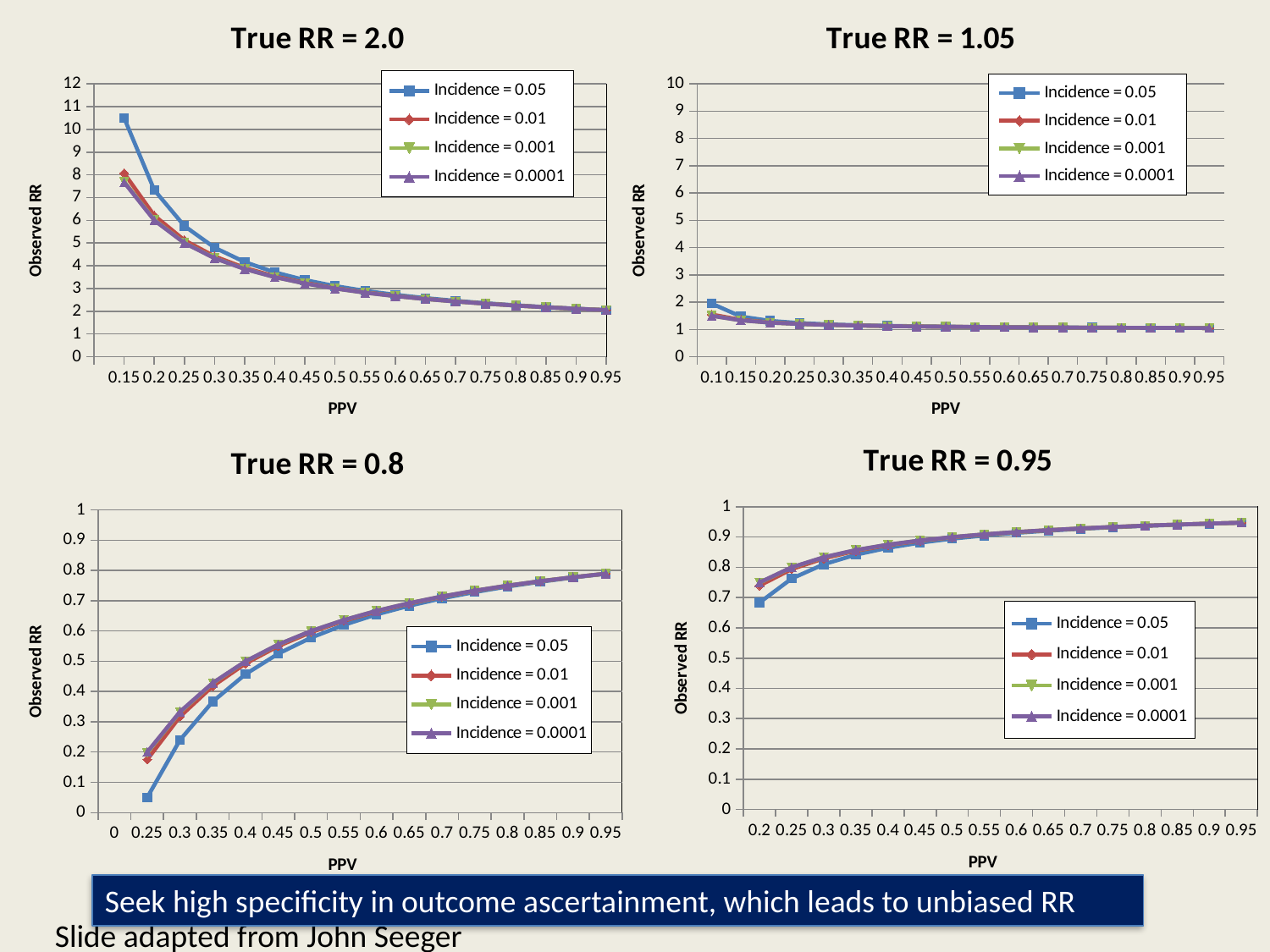
What is the y-axis label of the chart titled "True RR = 0.95"? Observed RR In the chart titled "True RR = 2.0", is the value for Incidence = 0.05 at PPV 0.15 greater or less than 10? greater In the chart titled "True RR = 0.8", at PPV 0.25, which is larger: the value for Incidence = 0.05 or the value for Incidence = 0.0001? Incidence = 0.0001 In the chart titled "True RR = 0.8", is the value for Incidence = 0.05 at PPV 0.25 greater or less than 0.1? less In the chart titled "True RR = 0.8", do the values rise or fall as PPV increases? rise How many PPV points are plotted along the x axis of the chart titled "True RR = 2.0"? 17 In the chart titled "True RR = 0.95", is the value for Incidence = 0.05 at PPV 0.2 greater or less than 0.7? less How many series does the legend list in the chart titled "True RR = 1.05"? 4 In the chart titled "True RR = 2.0", do the values rise or fall as PPV increases? fall In the chart titled "True RR = 2.0", which series has the highest value at PPV 0.15? Incidence = 0.05 What kind of chart is the one titled "True RR = 2.0"? line chart